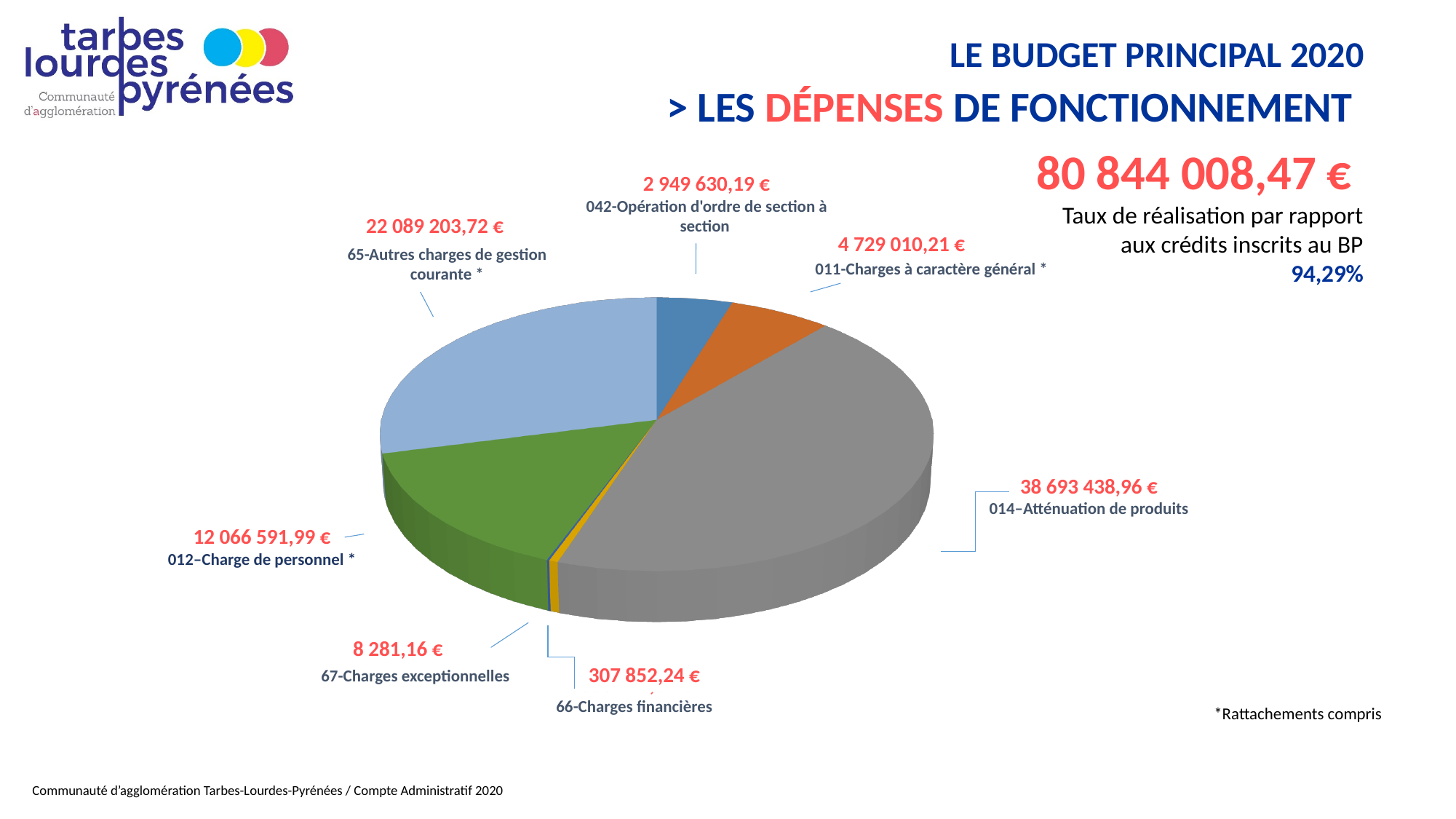
What is the value for 012–Charge de personnel? 12 066 591,99 € What is the value for 042-Opération d'ordre de section à section? 2 949 630,19 € Which category has the largest value in the pie chart? 014–Atténuation de produits How many slices does the pie chart have? 7 What is the difference between 014–Atténuation de produits and 65-Autres charges de gestion courante? 16 604 235,24 € What is the value for 65-Autres charges de gestion courante? 22 089 203,72 € What is the total of all the slices in the pie chart, as shown on the slide? 80 844 008,47 € What is the value for 014–Atténuation de produits? 38 693 438,96 € What is the value for 66-Charges financières? 307 852,24 € What kind of chart is shown on the slide? Pie chart Which category has the smallest value in the pie chart? 67-Charges exceptionnelles Which is larger: 011-Charges à caractère général or 012–Charge de personnel? 012–Charge de personnel